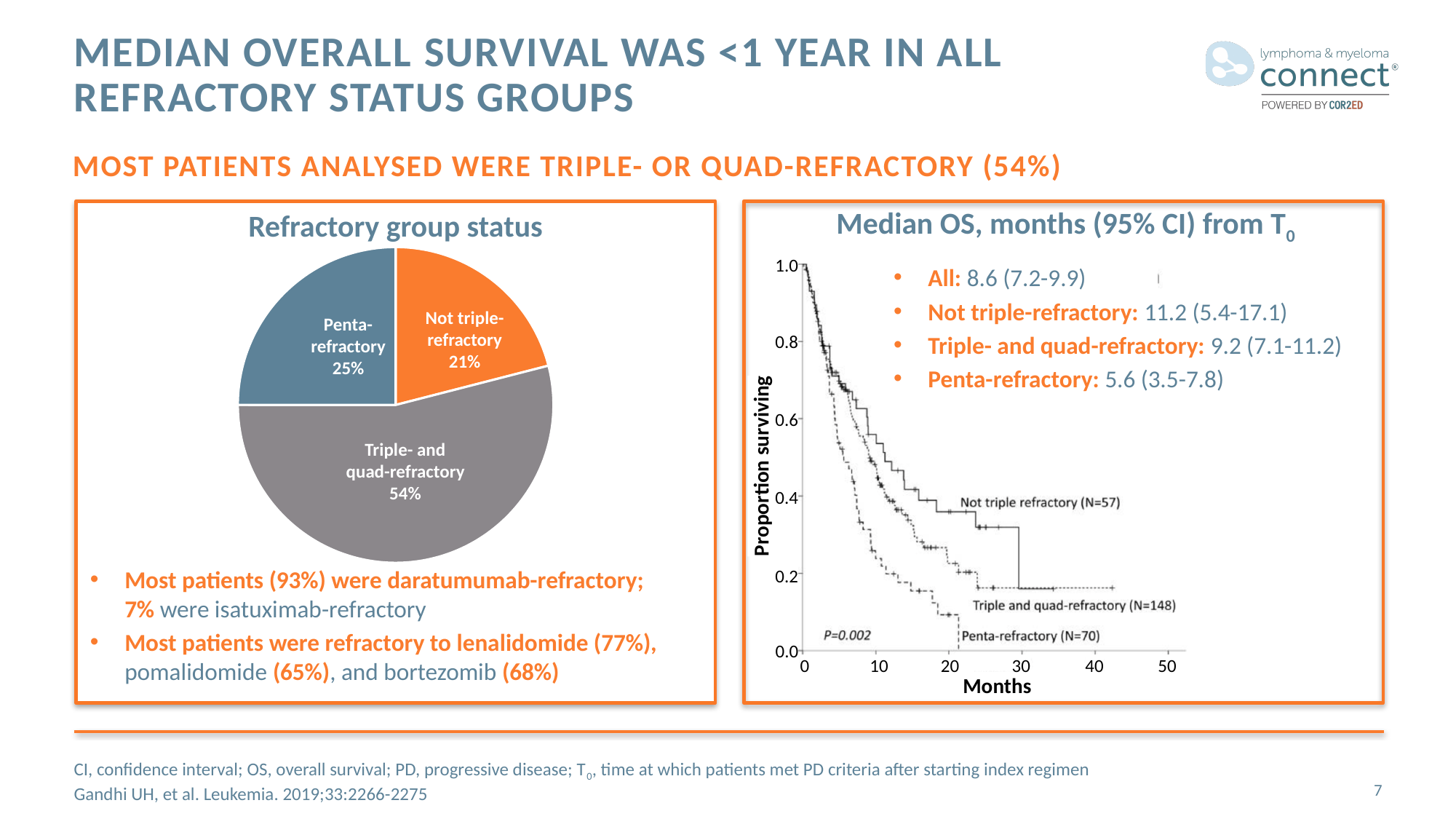
In the Median OS chart on the right, what is the label of the y axis? Proportion surviving In the Refractory group status pie chart, which slice is larger: penta-refractory or not triple-refractory? Penta-refractory What type of chart is the Refractory group status chart on the left? Pie chart How many slices does the Refractory group status pie chart have? 3 In the Refractory group status pie chart, what is the difference in percentage points between the triple- and quad-refractory slice and the penta-refractory slice? 29 In the Median OS chart on the right, how many patients (N) are in the triple and quad-refractory curve? 148 In the Refractory group status pie chart, what percentage of patients were triple- and quad-refractory? 54% In the Median OS chart on the right, what is the median OS in months for the penta-refractory group? 5.6 In the Refractory group status pie chart, what percentage of patients were not triple-refractory? 21% In the Refractory group status pie chart, which group has the smallest share? Not triple-refractory In the Refractory group status pie chart, which group has the largest share? Triple- and quad-refractory In the Refractory group status pie chart, what percentage of patients were penta-refractory? 25%